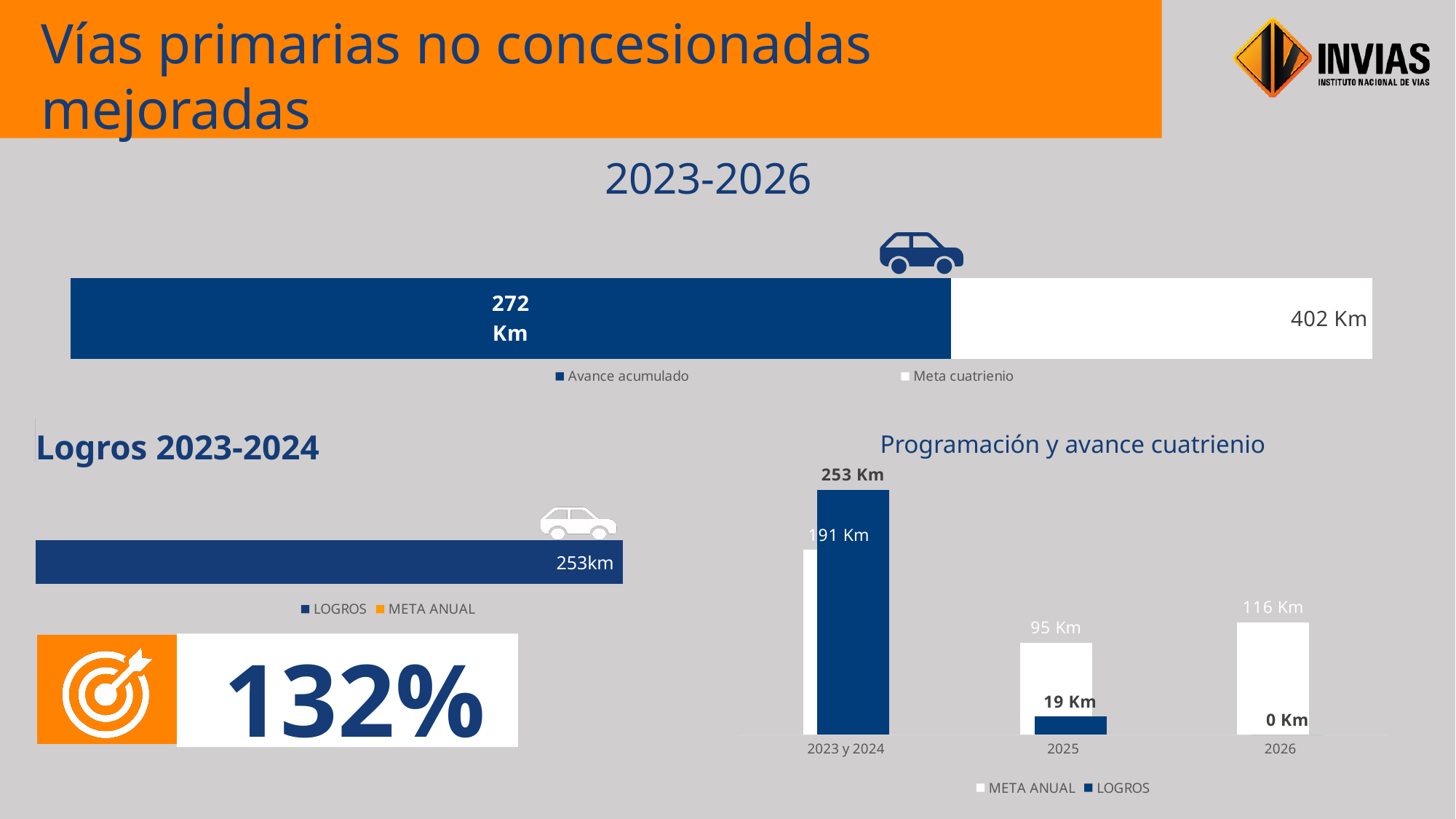
In the 'Programación y avance cuatrienio' chart, which year has the highest META ANUAL value? 2023 y 2024 In the 'Programación y avance cuatrienio' chart, what is the LOGROS value for 2023 y 2024? 253 Km In the 'Programación y avance cuatrienio' chart, which year has the lowest LOGROS value? 2026 In the 'Programación y avance cuatrienio' chart, what is the LOGROS value for 2026? 0 Km In the 'Programación y avance cuatrienio' chart, is the LOGROS value for 2025 larger or smaller than the META ANUAL value for 2025? smaller In the '2023-2026' chart at the top of the slide, what is the difference between Meta cuatrienio and Avance acumulado? 130 Km In the '2023-2026' chart at the top of the slide, what is the value for Avance acumulado? 272 Km How many year categories are shown on the x axis of the 'Programación y avance cuatrienio' chart? 3 How many series does the legend of the 'Programación y avance cuatrienio' chart list? 2 In the 'Programación y avance cuatrienio' chart, what is the difference between LOGROS and META ANUAL for 2023 y 2024? 62 Km In the 'Programación y avance cuatrienio' chart, what is the META ANUAL value for 2026? 116 Km In the 'Programación y avance cuatrienio' chart, what is the META ANUAL value for 2025? 95 Km